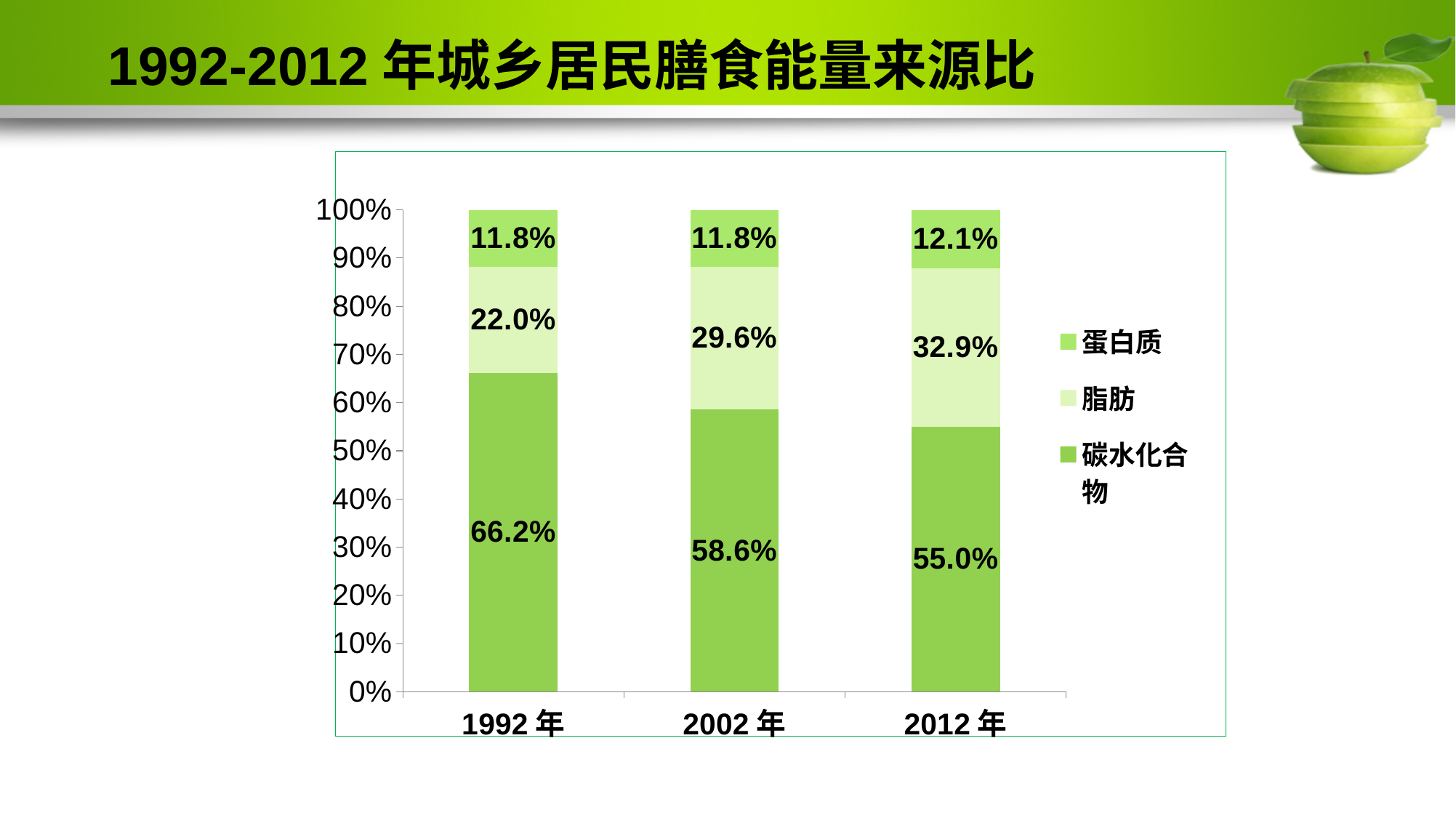
What is the value for 碳水化合物 in 1992年? 66.2% In which year is the 碳水化合物 share the lowest? 2012年 In which year is the 脂肪 share the highest? 2012年 What is the value for 蛋白质 in 2012年? 12.1% How many series does the legend list? 3 What is the value for 脂肪 in 2012年? 32.9% How does the 碳水化合物 share change from 1992年 to 2012年? It falls Which is larger: the 脂肪 value in 1992年 or in 2002年? 2002年 What is the value for 脂肪 in 2002年? 29.6% What kind of chart is shown on the slide? Stacked bar chart What is the difference between the 碳水化合物 values for 1992年 and 2012年? 11.2% How many years are shown on the x axis? 3